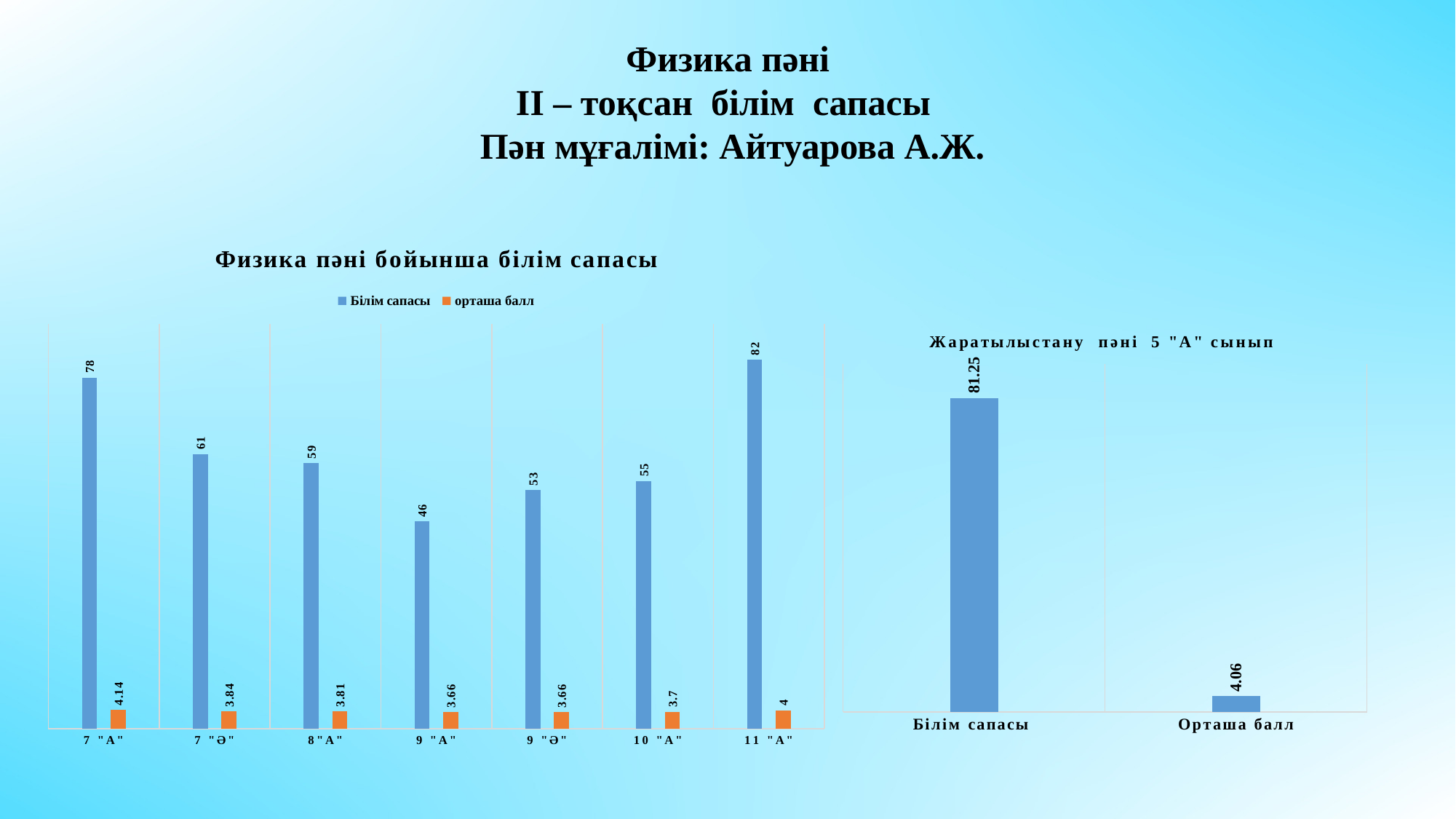
In the chart titled "Физика пәні бойынша білім сапасы", how many classes are shown on the x axis? 7 In the chart titled "Физика пәні бойынша білім сапасы", which class has the lowest Білім сапасы value? 9 "А" In the chart titled "Физика пәні бойынша білім сапасы", how many series does the legend list? 2 In the chart titled "Физика пәні бойынша білім сапасы", what is the орташа балл value for 9 "Ә"? 3.66 In the chart titled "Физика пәні бойынша білім сапасы", which class has the highest орташа балл value? 7 "А" In the chart titled "Физика пәні бойынша білім сапасы", what is the Білім сапасы value for 7 "А"? 78 What kind of chart is the one titled "Жаратылыстану пәні 5 "А" сынып"? Bar chart In the chart titled "Жаратылыстану пәні 5 "А" сынып", what is the value for Орташа балл? 4.06 In the chart titled "Физика пәні бойынша білім сапасы", which class has the highest Білім сапасы value? 11 "А" In the chart titled "Физика пәні бойынша білім сапасы", which has a larger Білім сапасы value, 7 "Ә" or 10 "А"? 7 "Ә" In the chart titled "Жаратылыстану пәні 5 "А" сынып", what is the value for Білім сапасы? 81.25 In the chart titled "Физика пәні бойынша білім сапасы", what is the difference between the Білім сапасы values for 11 "А" and 7 "А"? 4